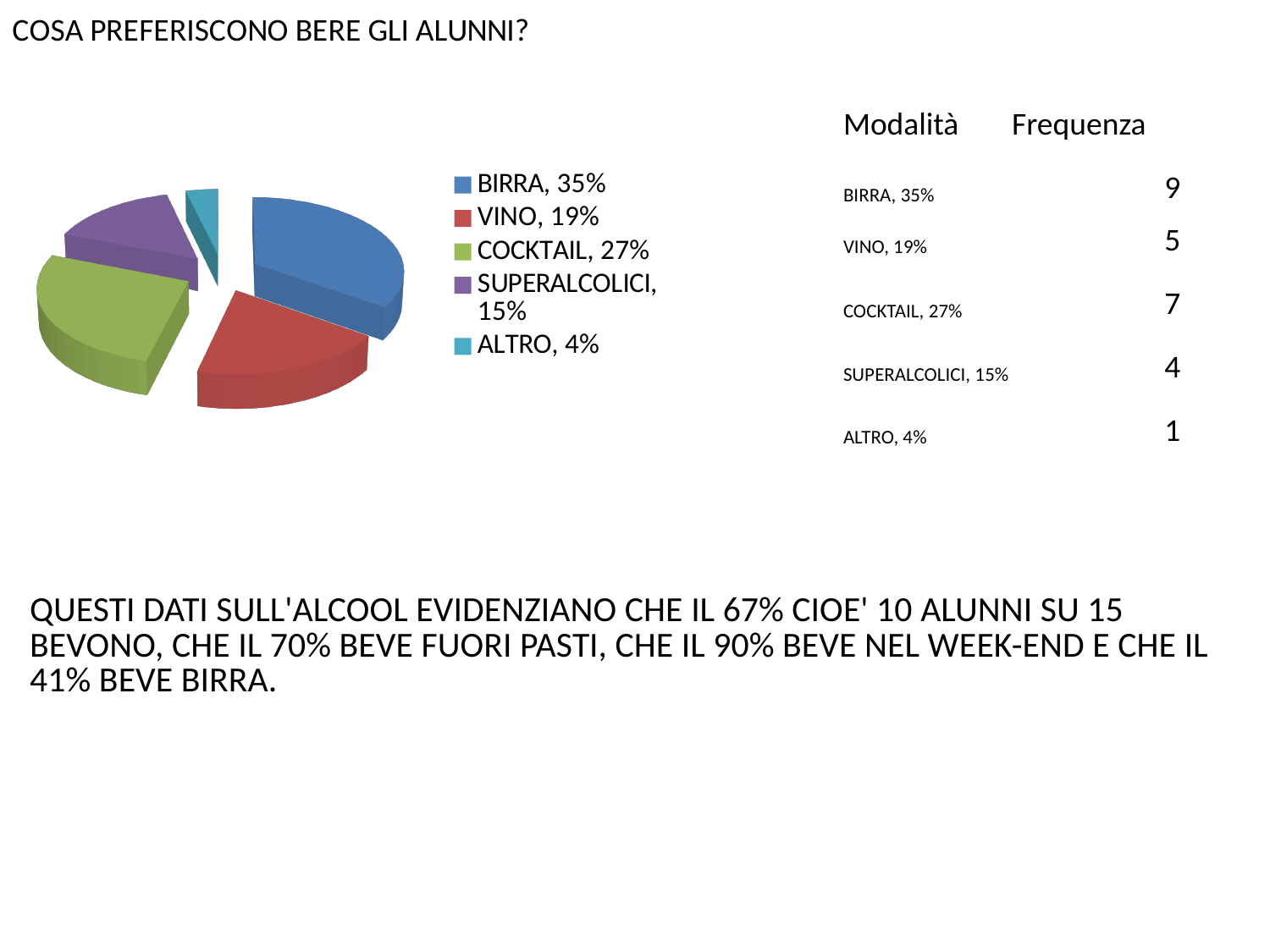
How many slices does the pie chart have? 5 What colour is the VINO slice in the pie chart? red What is the difference in percentage points between the BIRRA slice and the VINO slice? 16 Which category is shown in green in the pie chart legend? COCKTAIL What share of the pie does COCKTAIL have? 27% Which slice is larger, VINO or COCKTAIL? COCKTAIL Which category has the smallest slice of the pie? ALTRO Which category has the largest slice of the pie? BIRRA What share of the pie does BIRRA have? 35% What is the difference in percentage points between the COCKTAIL slice and the ALTRO slice? 23 What share of the pie does SUPERALCOLICI have? 15% What kind of chart is shown on the slide? pie chart